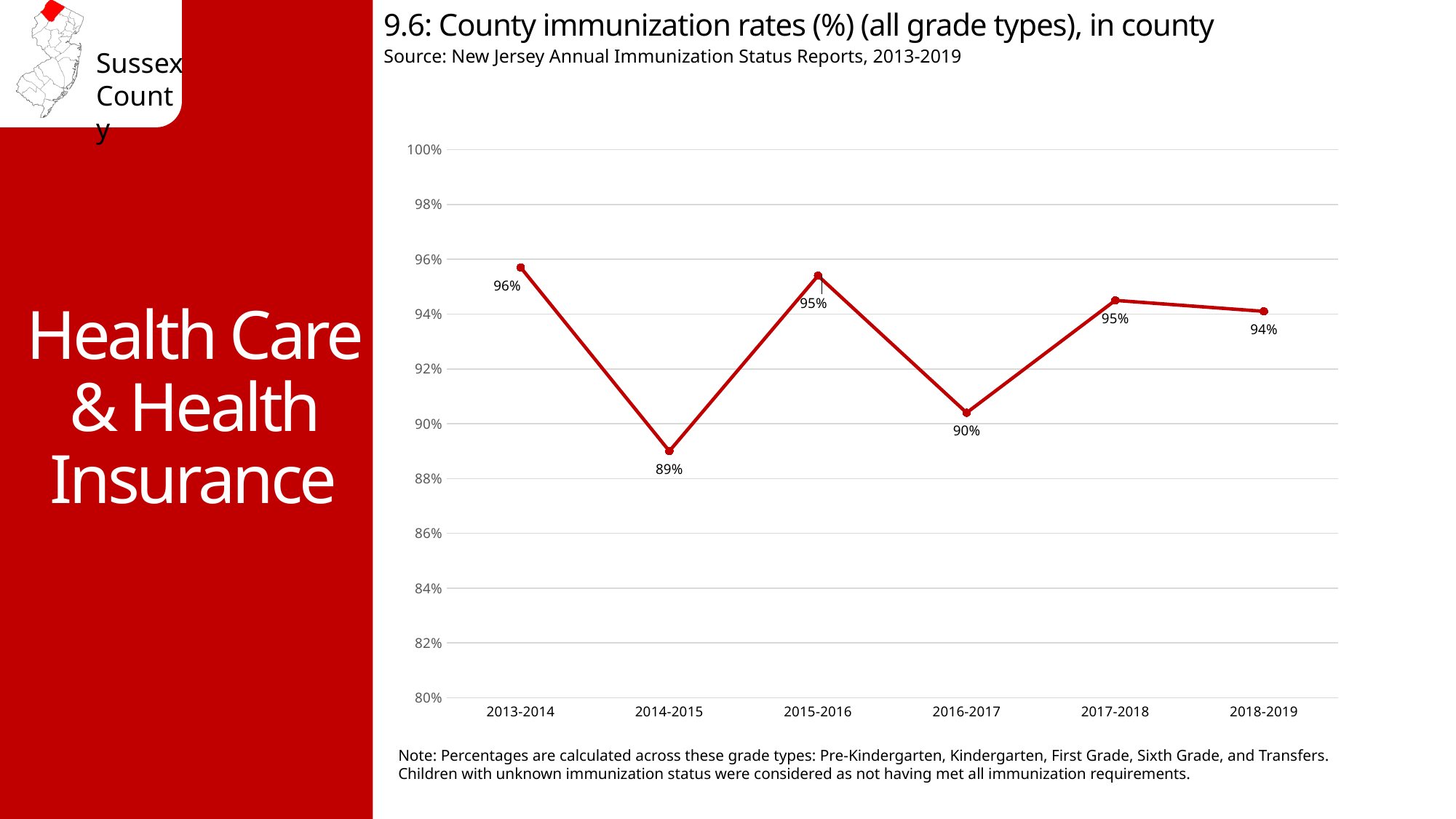
What is the county immunization rate for 2014-2015? 89% What kind of chart is shown on the slide? line chart Which is larger, the immunization rate for 2015-2016 or for 2016-2017? 2015-2016 Which school year has the highest immunization rate? 2013-2014 Which school year has the lowest immunization rate? 2014-2015 What is the county immunization rate for 2016-2017? 90% What is the difference between the immunization rates for 2013-2014 and 2014-2015? 7% What is the county immunization rate for 2013-2014? 96% Did the immunization rate rise or fall from 2017-2018 to 2018-2019? fall Is the immunization rate for 2016-2017 greater or less than 92%? less What is the county immunization rate for 2018-2019? 94% How many school years are plotted on the chart? 6